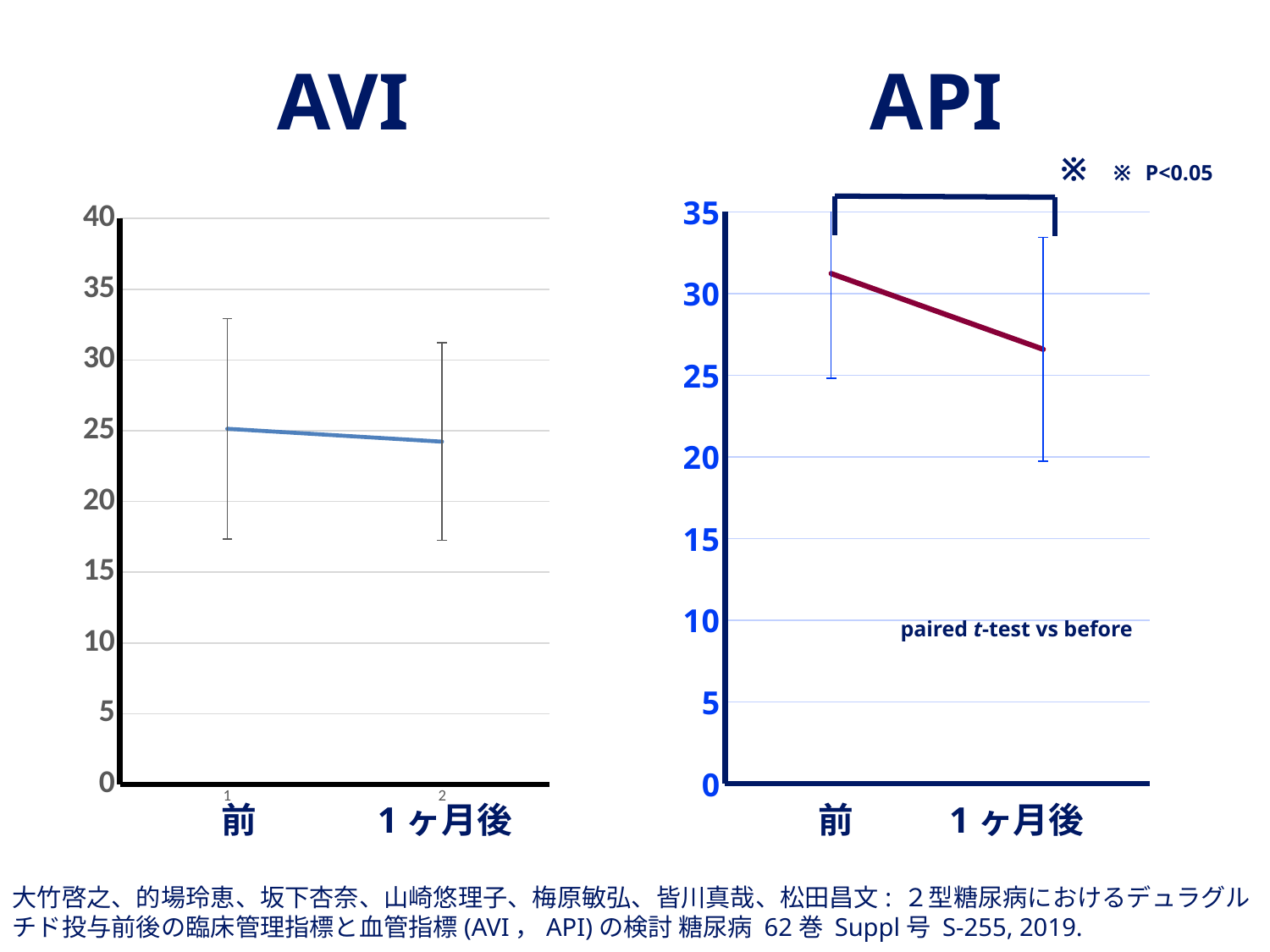
What kind of chart is the API chart? line chart What kind of chart is the AVI chart? line chart How many time points are plotted on the API chart? 2 On the AVI chart, is the value for 前 greater or less than 20? greater What significance level does the ※ mark on the API chart indicate? P<0.05 On the API chart, does the value rise or fall from 前 to 1ヶ月後? fall On the API chart, is the value for 前 greater or less than 30? greater On the API chart, which time point has the higher value, 前 or 1ヶ月後? 前 On the AVI chart, does the value rise or fall from 前 to 1ヶ月後? fall On the API chart, is the value for 1ヶ月後 greater or less than 25? greater